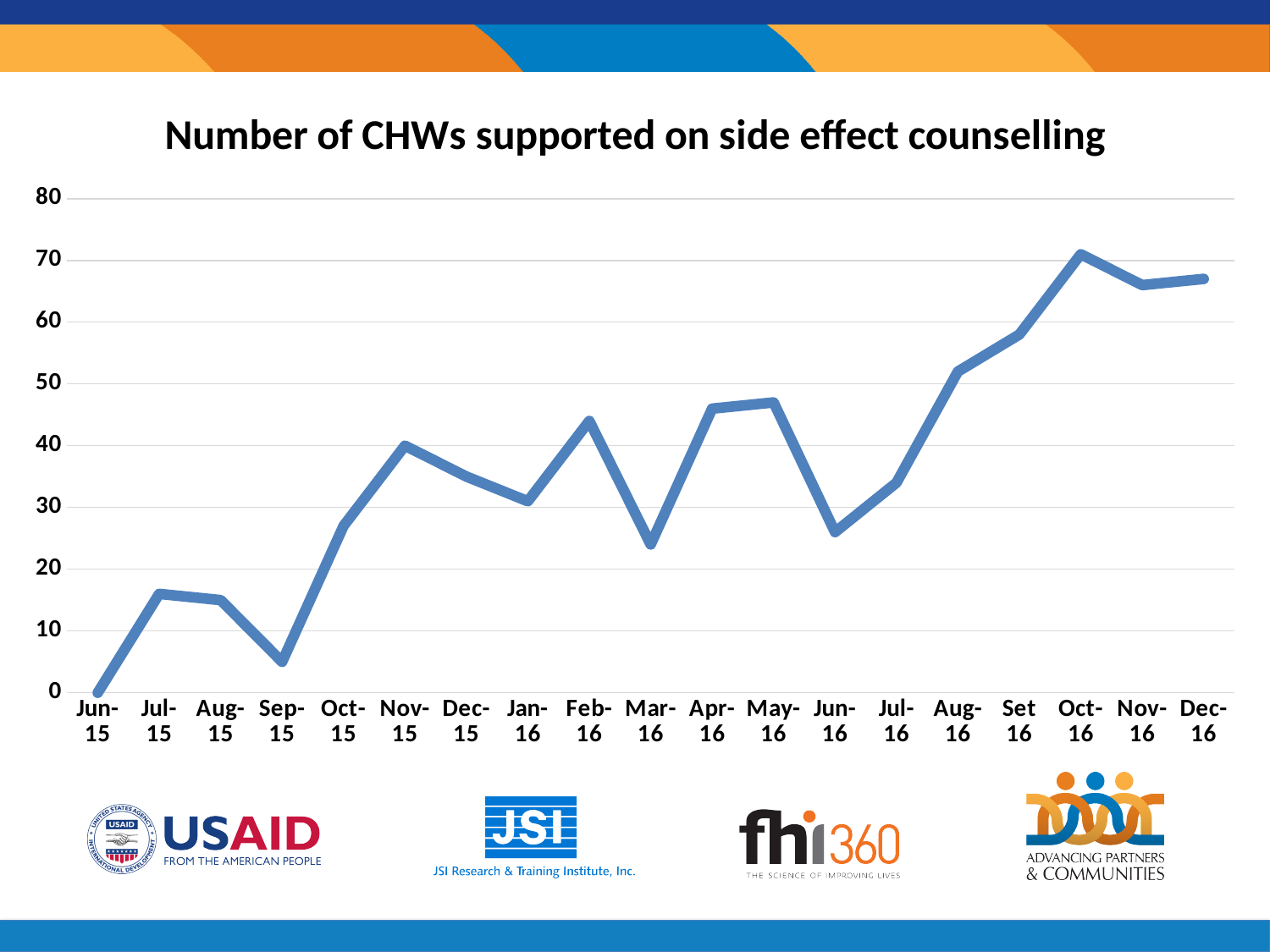
Which is higher, the value for Oct-15 or the value for Nov-15? Nov-15 What kind of chart is shown on the slide? line chart Which is higher, the value for Apr-16 or the value for Jul-16? Apr-16 Is the value for Sep-15 greater or less than 10? less Is the value for Mar-16 greater or less than 30? less Which month has the highest number of CHWs supported on side effect counselling? Oct-16 Which month has the lowest number of CHWs supported on side effect counselling? Jun-15 Is the value for Aug-16 greater or less than 50? greater What is the title of the chart? Number of CHWs supported on side effect counselling Overall, do the values rise or fall from Jun-15 to Dec-16? rise How many months are plotted on the x axis? 19